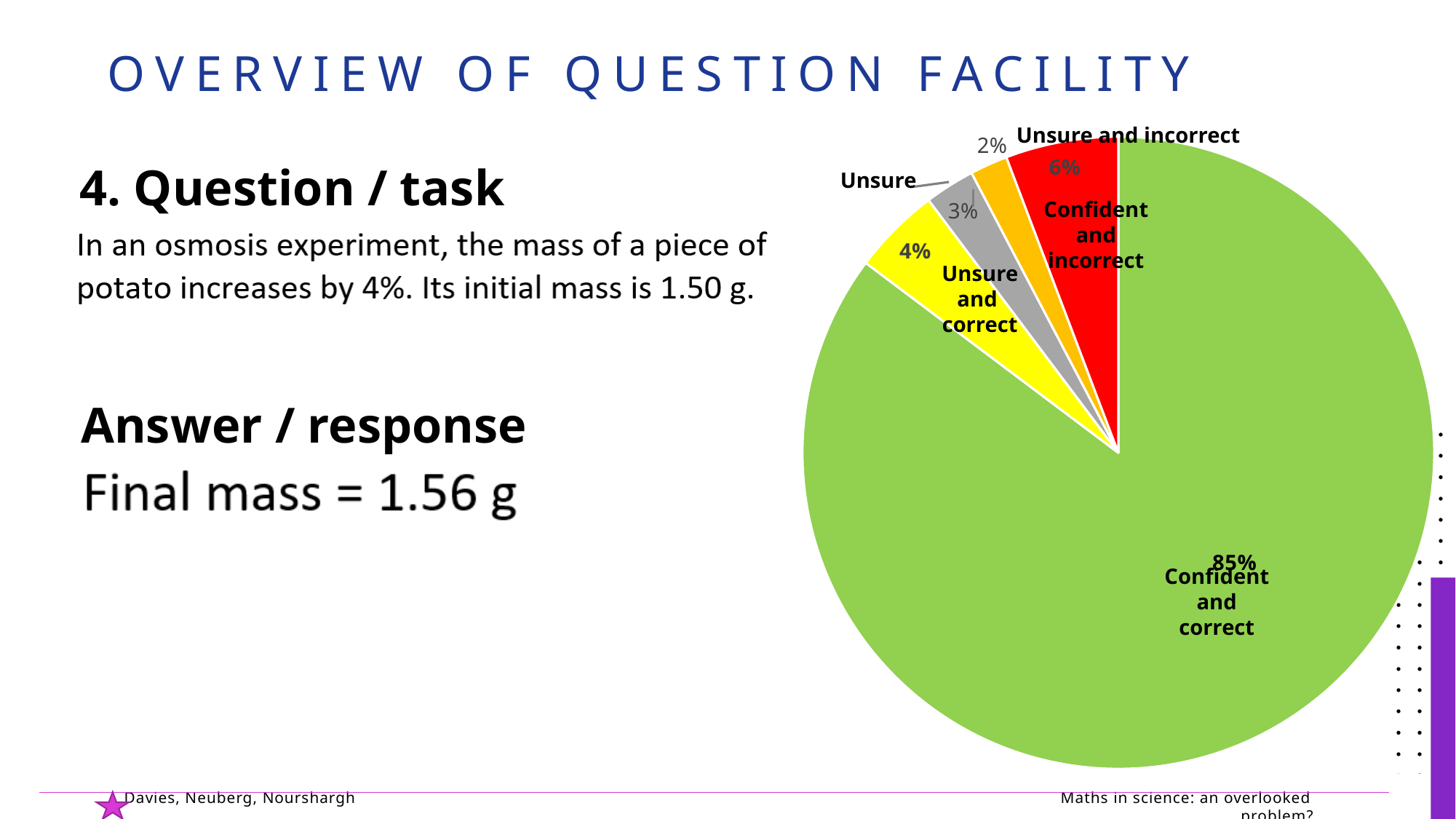
Which slice of the pie chart is the smallest? Unsure and incorrect What type of chart is shown on the slide? pie chart What percentage of the pie is 'Unsure and incorrect'? 2% What percentage of the pie is 'Unsure'? 3% What percentage of the pie is 'Unsure and correct'? 4% Which slice of the pie chart is the largest? Confident and correct What is the difference in percentage points between 'Confident and correct' and 'Confident and incorrect'? 79 What percentage of the pie is 'Confident and incorrect'? 6% What colour is the 'Confident and incorrect' slice? red What percentage of the pie is 'Confident and correct'? 85% How many slices does the pie chart have? 5 Which is larger, 'Unsure and correct' or 'Unsure'? Unsure and correct